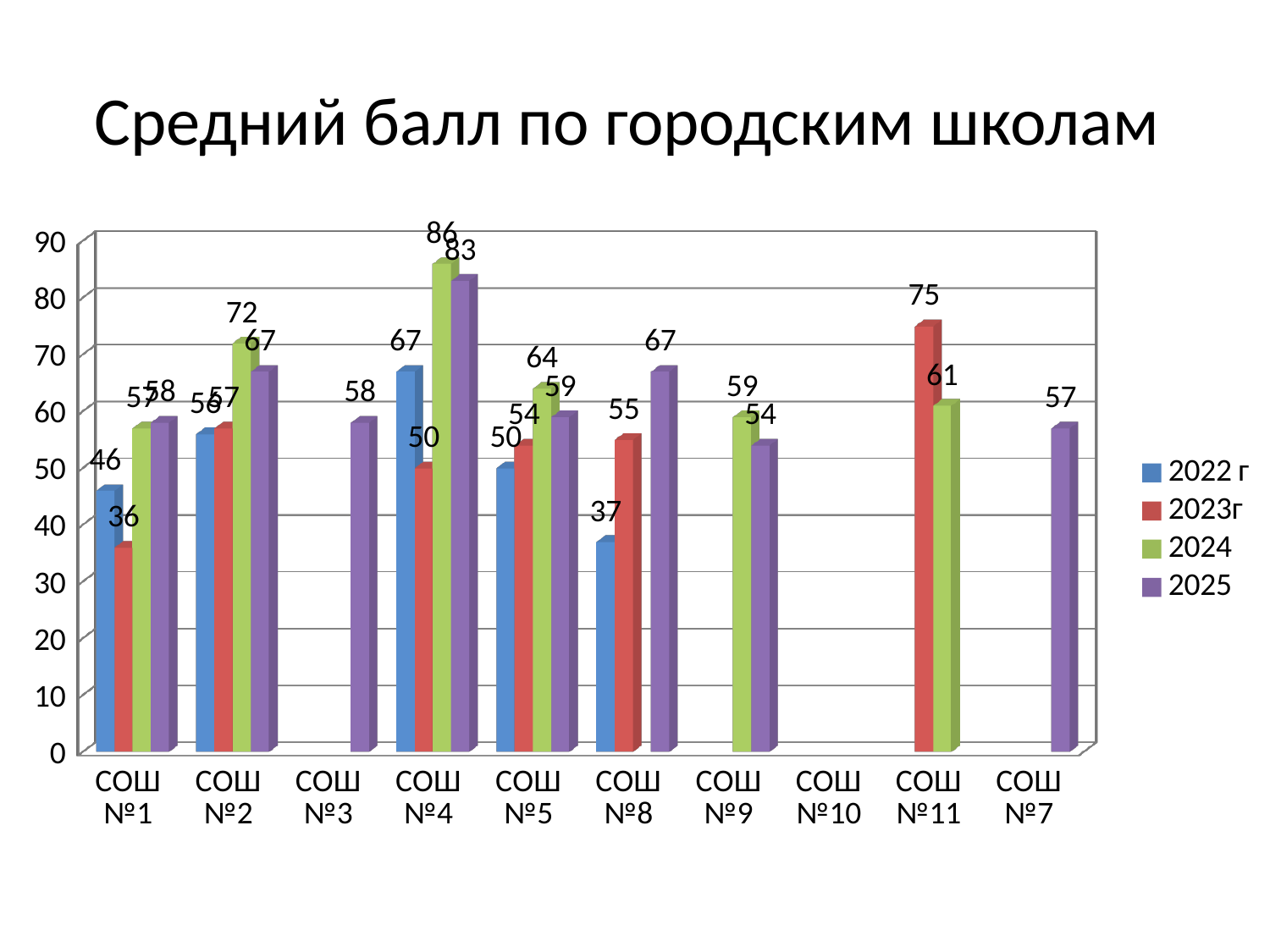
Which school has the lowest 2023г value? СОШ №1 How many series does the legend list? 4 What is the title of the chart? Средний балл по городским школам Which is larger for СОШ №5: the 2024 value or the 2025 value? 2024 What is the 2025 value for СОШ №7? 57 What is the 2024 value for СОШ №4? 86 What is the 2023г value for СОШ №11? 75 How many school categories are shown on the x axis? 10 What is the 2022 г value for СОШ №8? 37 What type of chart is shown on the slide? bar chart Which school has the highest 2024 value? СОШ №4 What is the difference between the 2024 and 2025 values for СОШ №4? 3